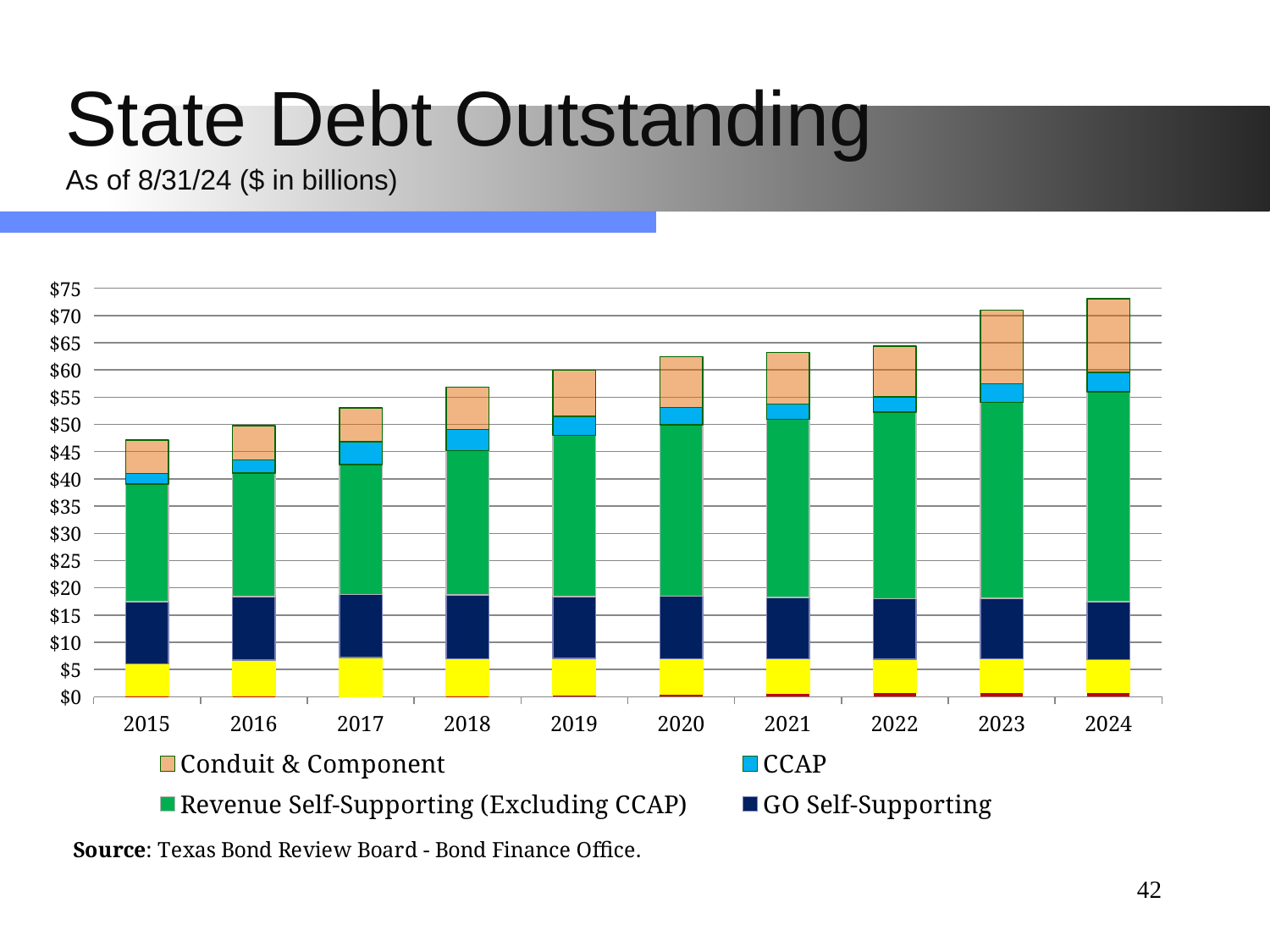
Is the total bar for 2015 greater or less than $45? greater Which year has a larger total bar, 2019 or 2023? 2023 How many series does the chart's legend list? 4 Which year has the lowest total state debt outstanding? 2015 What kind of chart is shown on the slide? stacked bar chart Do the total bar heights generally rise or fall from 2015 to 2024? rise Which year has a larger total bar, 2016 or 2022? 2022 Is the total bar for 2018 greater or less than $60? less What is the title of the slide containing the chart? State Debt Outstanding Is the total bar for 2024 greater or less than $70? greater Which year has the highest total state debt outstanding? 2024 How many years are shown along the x axis of the chart? 10